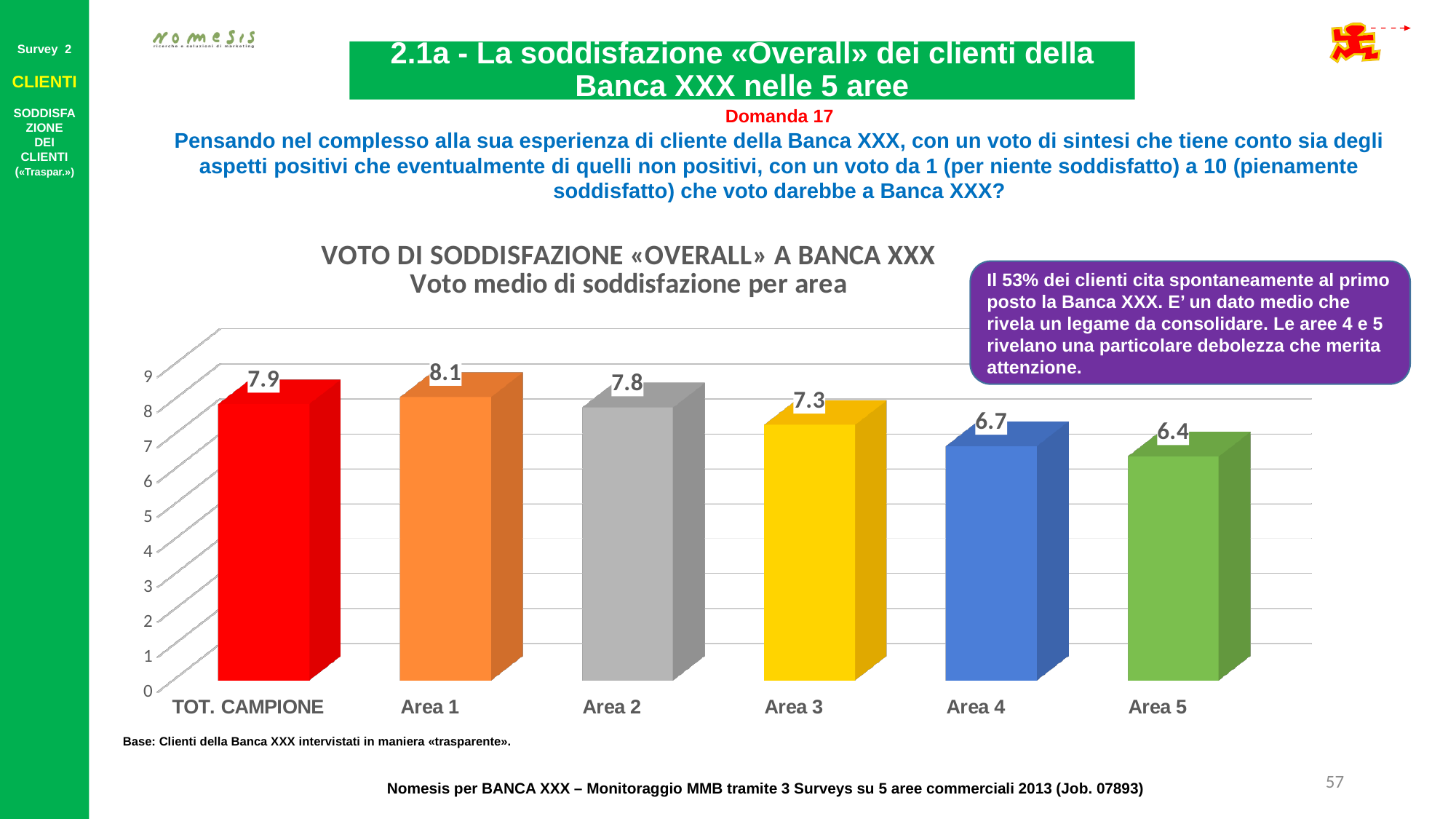
What is the difference between the scores of Area 1 and Area 5? 1.7 What is the average satisfaction score for Area 5? 6.4 Which category has the lowest average satisfaction score? Area 5 What kind of chart is shown on the slide? Bar chart Is the value for Area 4 greater or less than 7? less What is the average satisfaction score for TOT. CAMPIONE? 7.9 What is the average satisfaction score for Area 1? 8.1 Do the values rise or fall from Area 1 to Area 5 along the x axis? Fall Which area has the highest average satisfaction score? Area 1 How many categories are shown on the x axis of the chart? 6 What is the difference between the scores of Area 3 and Area 4? 0.6 Which has a higher score, Area 2 or Area 3? Area 2